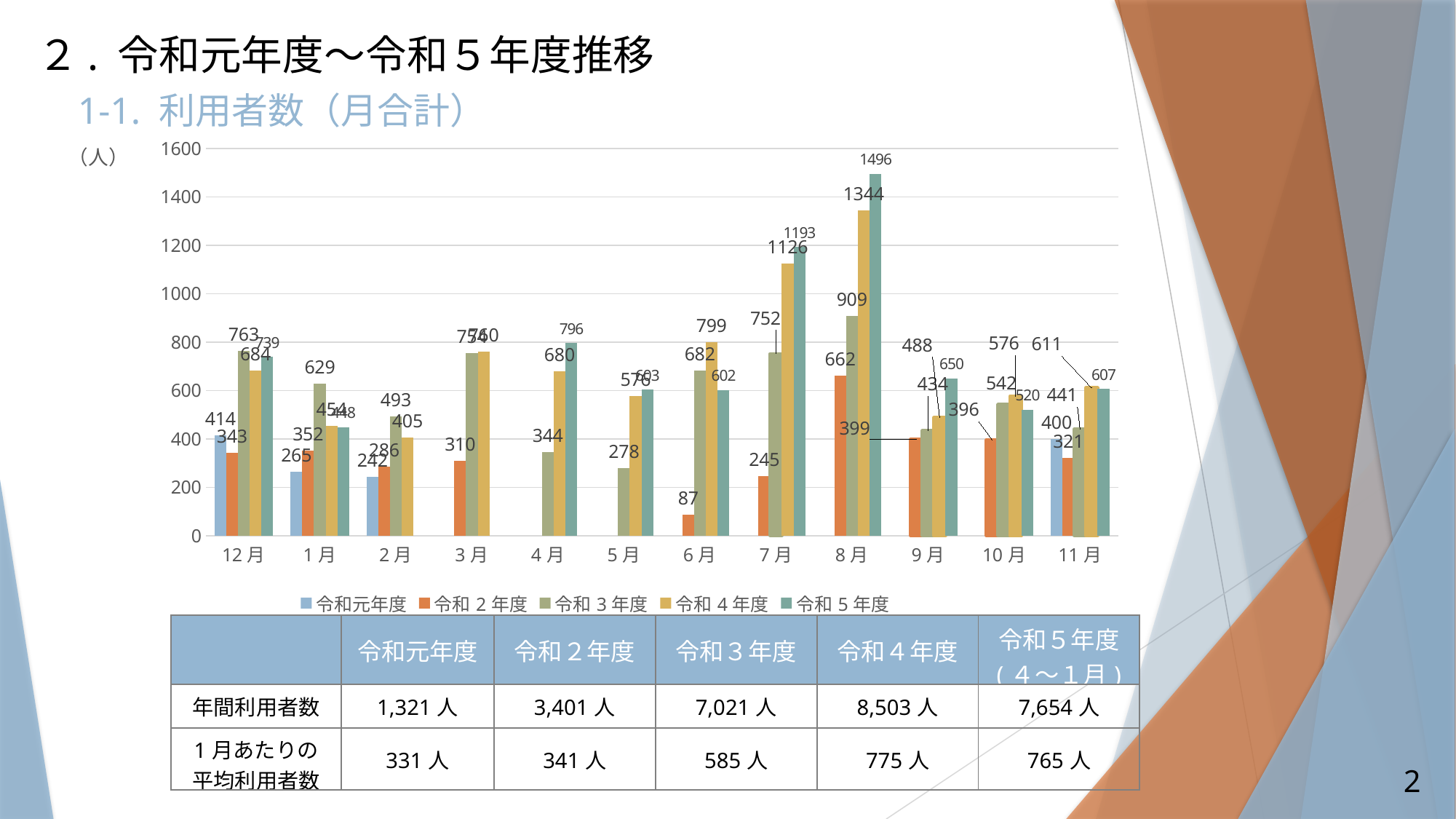
Which is larger in 11月, the 令和4年度 value or the 令和5年度 value? 令和4年度 Which series is shown in orange in the chart legend? 令和2年度 In which month is the 令和4年度 value highest? 8月 Is the value for 令和3年度 in 8月 greater or less than 800? greater What is the difference between the 令和5年度 and 令和4年度 values in 8月? 152 What is the value for 令和5年度 in 8月? 1496 What kind of chart is shown on the slide? bar chart How many series does the chart legend list? 5 What is the value for 令和4年度 in 7月? 1126 What is the value for 令和2年度 in 6月? 87 How many month categories are shown on the x axis of the chart? 12 In which month is the 令和2年度 value lowest? 6月